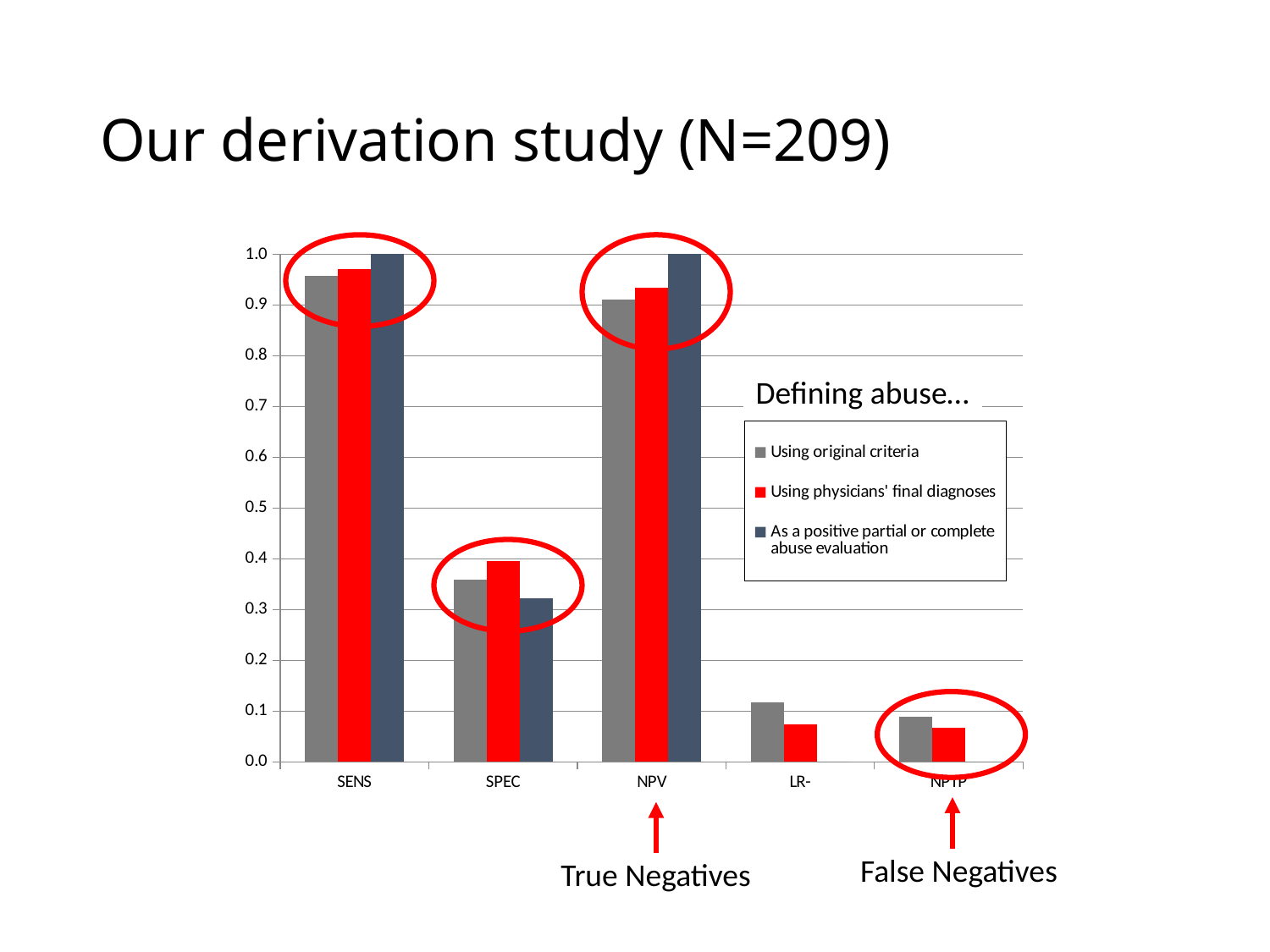
Is the value for LR- in the 'Using original criteria' series greater or less than 0.1? greater Which category has the highest value in the 'Using original criteria' series? SENS Is the value for SPEC in the 'Using original criteria' series greater or less than 0.4? less How many categories are shown on the x axis? 5 What is the title of the slide? Our derivation study (N=209) What is the value for SENS in the 'As a positive partial or complete abuse evaluation' series? 1.0 What kind of chart is shown on the slide? bar chart For SPEC, which series has the larger value: 'Using physicians' final diagnoses' or 'As a positive partial or complete abuse evaluation'? Using physicians' final diagnoses How many series does the legend list? 3 What is the value for NPV in the 'As a positive partial or complete abuse evaluation' series? 1.0